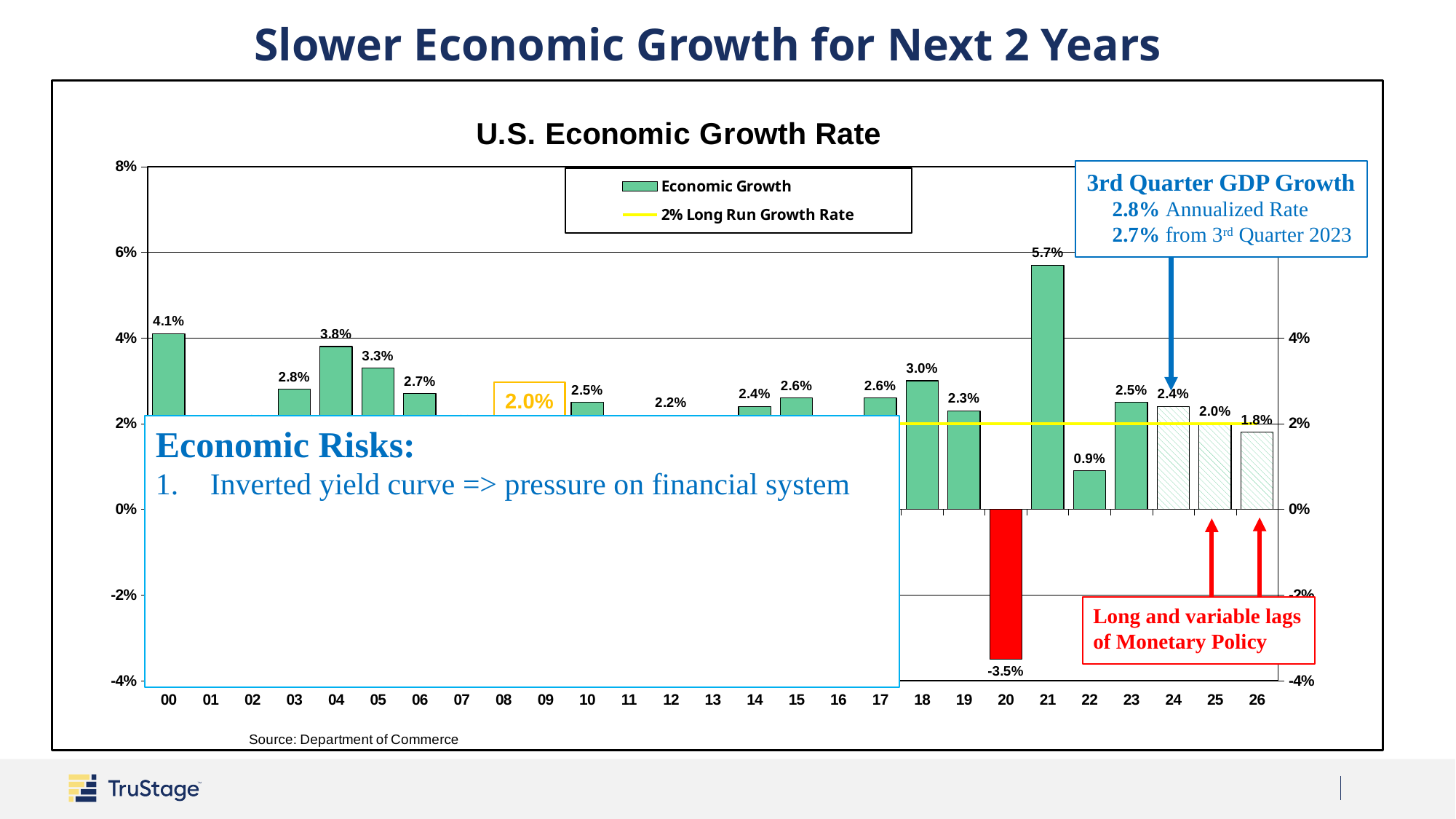
What is the economic growth rate shown for 2020 (20)? -3.5% Which year has the highest economic growth rate in the chart? 21 What is the difference between the growth rates for 24 and 26? 0.6 percentage points What is the economic growth rate shown for 2021 (21) in the U.S. Economic Growth Rate chart? 5.7% How many series does the legend list? 2 What is the economic growth rate shown for 26? 1.8% Which year has the larger growth rate, 04 or 05? 04 What is the difference between the growth rates for 21 and 20? 9.2 percentage points Is the growth rate for 22 greater or less than 2%? less Which year has the lowest economic growth rate in the chart? 20 What is the title of the chart? U.S. Economic Growth Rate What kind of chart is used to show the U.S. Economic Growth Rate? Combination bar and line chart